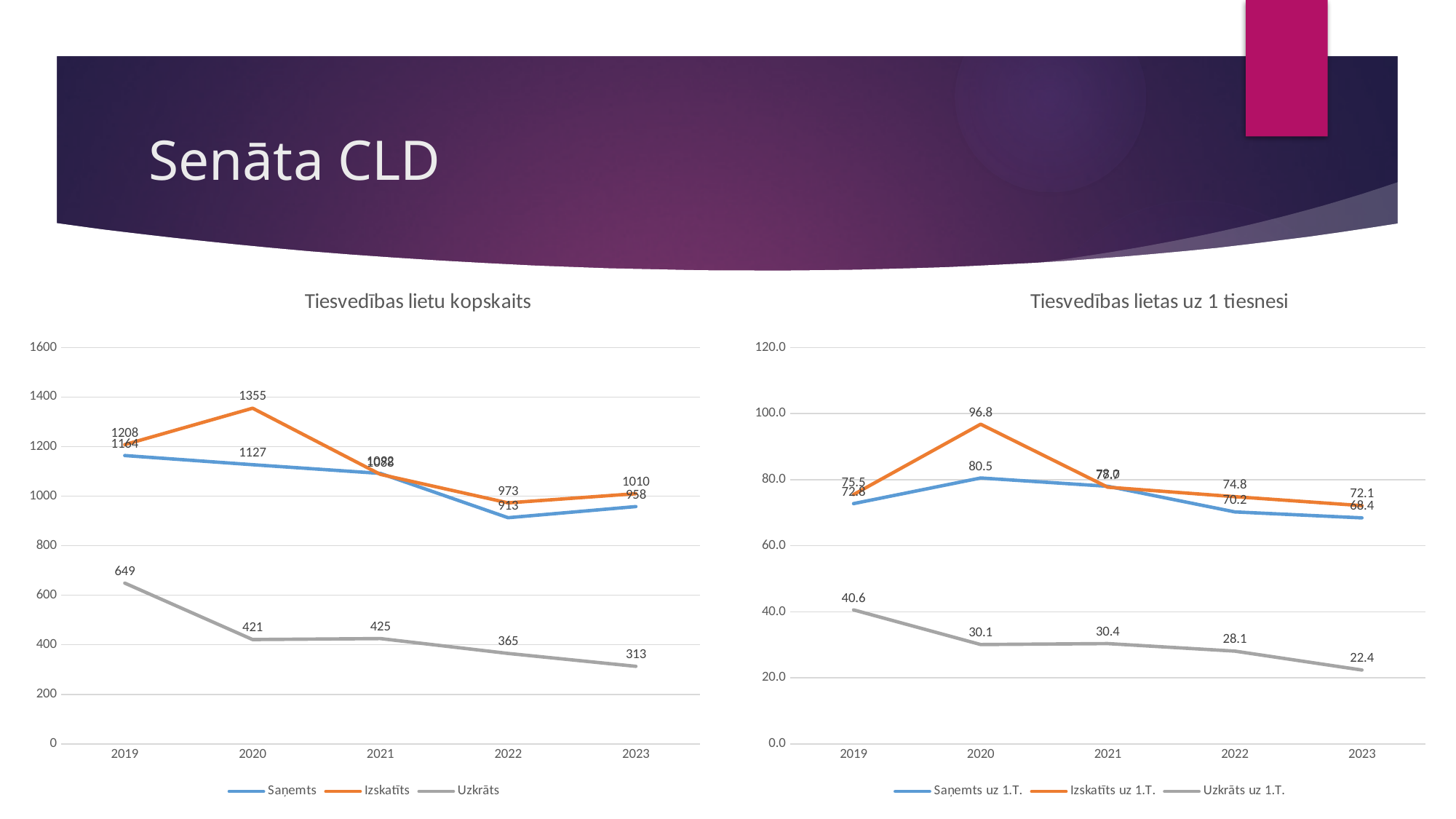
In the chart titled 'Tiesvedības lietu kopskaits', what is the value of Izskatīts in 2020? 1355 In the chart titled 'Tiesvedības lietas uz 1 tiesnesi', what is the value of Izskatīts uz 1.T. in 2020? 96.8 How many years are shown on the x axis of the chart titled 'Tiesvedības lietas uz 1 tiesnesi'? 5 How many series does the legend of the chart titled 'Tiesvedības lietu kopskaits' list? 3 In the chart titled 'Tiesvedības lietu kopskaits', what is the difference between the Uzkrāts values for 2019 and 2023? 336 In the chart titled 'Tiesvedības lietas uz 1 tiesnesi', what is the value of Uzkrāts uz 1.T. in 2023? 22.4 In the chart titled 'Tiesvedības lietu kopskaits', what is the value of Uzkrāts in 2019? 649 In the chart titled 'Tiesvedības lietu kopskaits', which series has the larger value in 2022, Saņemts or Izskatīts? Izskatīts In the chart titled 'Tiesvedības lietu kopskaits', in which year is Izskatīts highest? 2020 In the chart titled 'Tiesvedības lietas uz 1 tiesnesi', does the Uzkrāts uz 1.T. series generally rise or fall from 2019 to 2023? Fall In the chart titled 'Tiesvedības lietu kopskaits', in which year is Uzkrāts lowest? 2023 What type of chart is the one titled 'Tiesvedības lietu kopskaits'? Line chart